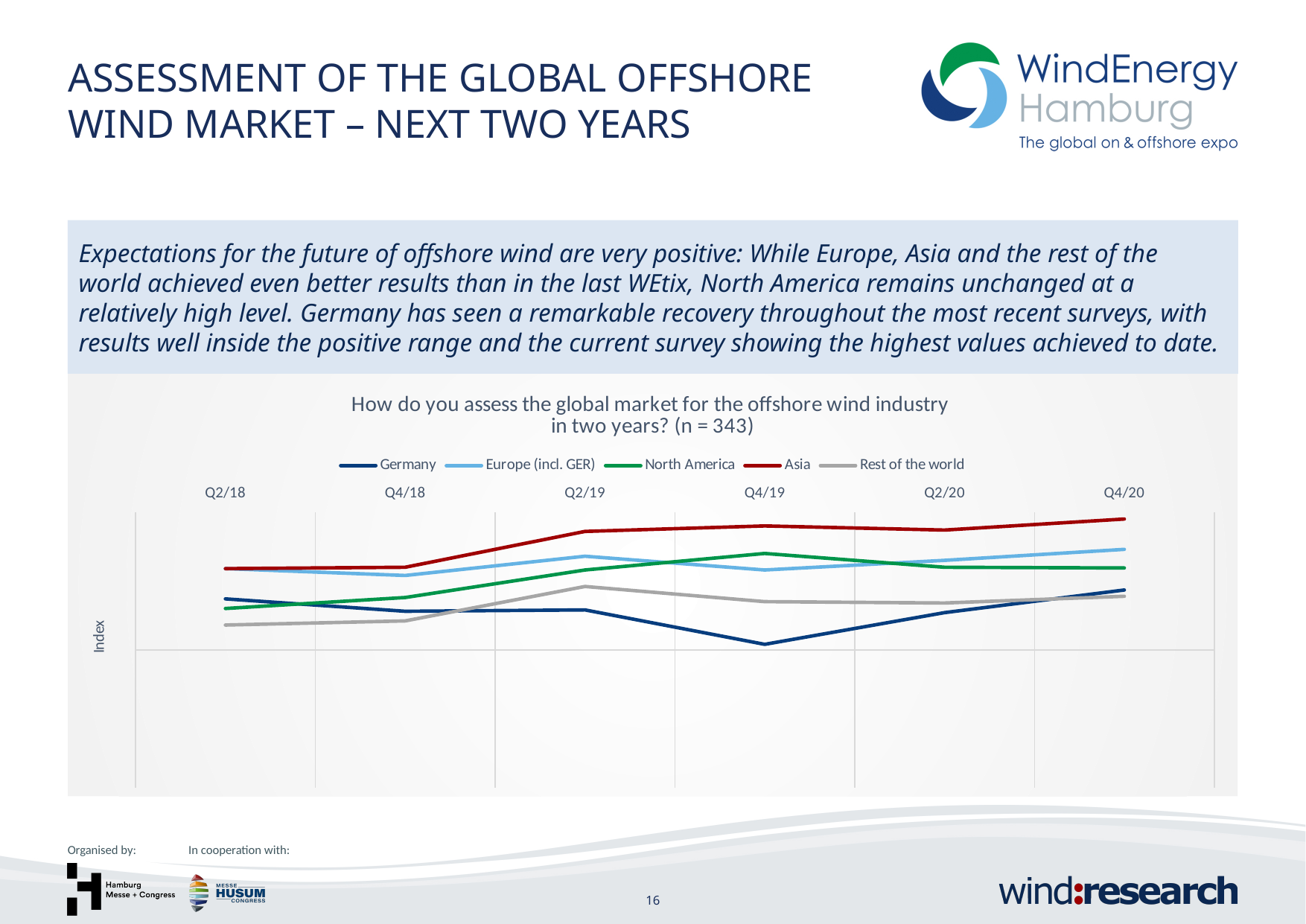
Does the value for Asia rise or fall from Q2/18 to Q4/20? Rise How many survey periods are shown along the x axis? 6 What is the sample size (n) given in the chart title? 343 Which series has the highest value at Q4/20? Asia What is the first x-axis label on the chart? Q2/18 Does the value for Germany rise or fall from Q2/19 to Q4/19? Fall At Q4/19, which is larger: the value for Asia or the value for Germany? Asia What kind of chart is shown on the slide? Line chart At Q2/18, which is larger: the value for Germany or the value for Rest of the world? Germany How many series does the legend list? 5 Which series has the highest value at Q4/19? Asia Which series has the lowest value at Q4/19? Germany